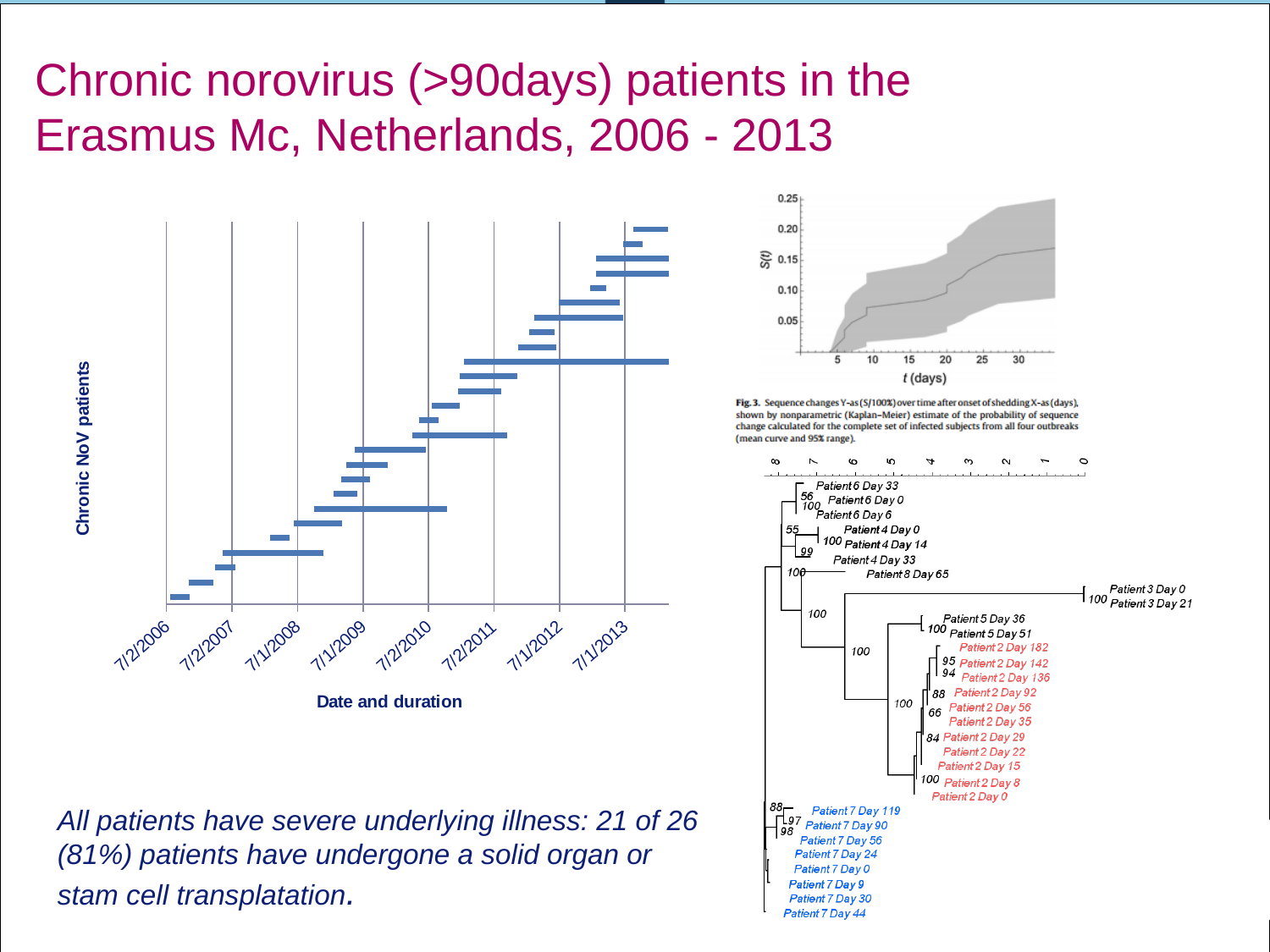
On the Kaplan-Meier chart (Fig. 3) at the top right, is the mean curve value at t = 10 days greater or less than 0.10? less On the Kaplan-Meier chart (Fig. 3) at the top right, does the mean curve rise or fall as t increases? rise What is the x-axis label of the main chart on the left? Date and duration On the main chart on the left, does the lowest bar start before or after 7/2/2007? before What is the y-axis label of the main chart on the left? Chronic NoV patients On the Kaplan-Meier chart (Fig. 3) at the top right, what is the highest value shown on the y axis? 0.25 On the main chart on the left, does the longest bar span from before 7/2/2011 to after 7/1/2013? yes On the main chart on the left, what is the earliest date label on the x axis? 7/2/2006 On the main chart on the left, what is the latest date label on the x axis? 7/1/2013 On the Kaplan-Meier chart (Fig. 3) at the top right, what is the label of the x axis? t (days) How many date tick labels are shown on the x axis of the main chart on the left? 8 What kind of chart is the main chart on the left of the slide? bar chart